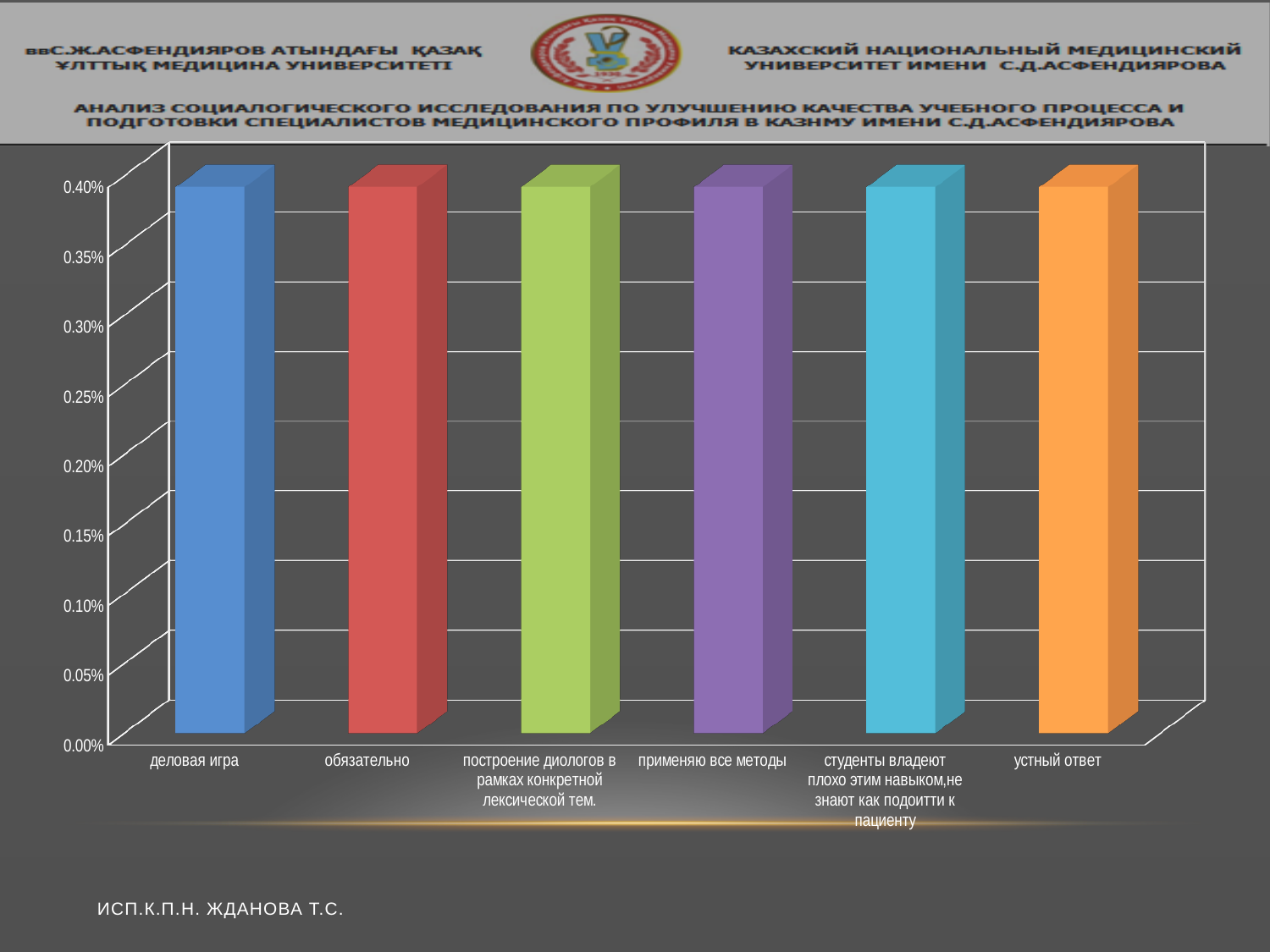
Is the value for "устный ответ" greater or less than 0.30%? greater Is the value for "применяю все методы" greater or less than 0.10%? greater What is the highest tick value shown on the vertical axis? 0.40% Is the value for "деловая игра" greater or less than 0.20%? greater What colour is the bar for "деловая игра"? blue Do the bar values rise, fall, or stay the same from left to right across the categories? stay the same How many categories (bars) are plotted in the chart? 6 What kind of chart is shown on the slide? bar chart What is the label of the last (rightmost) category on the x axis? устный ответ